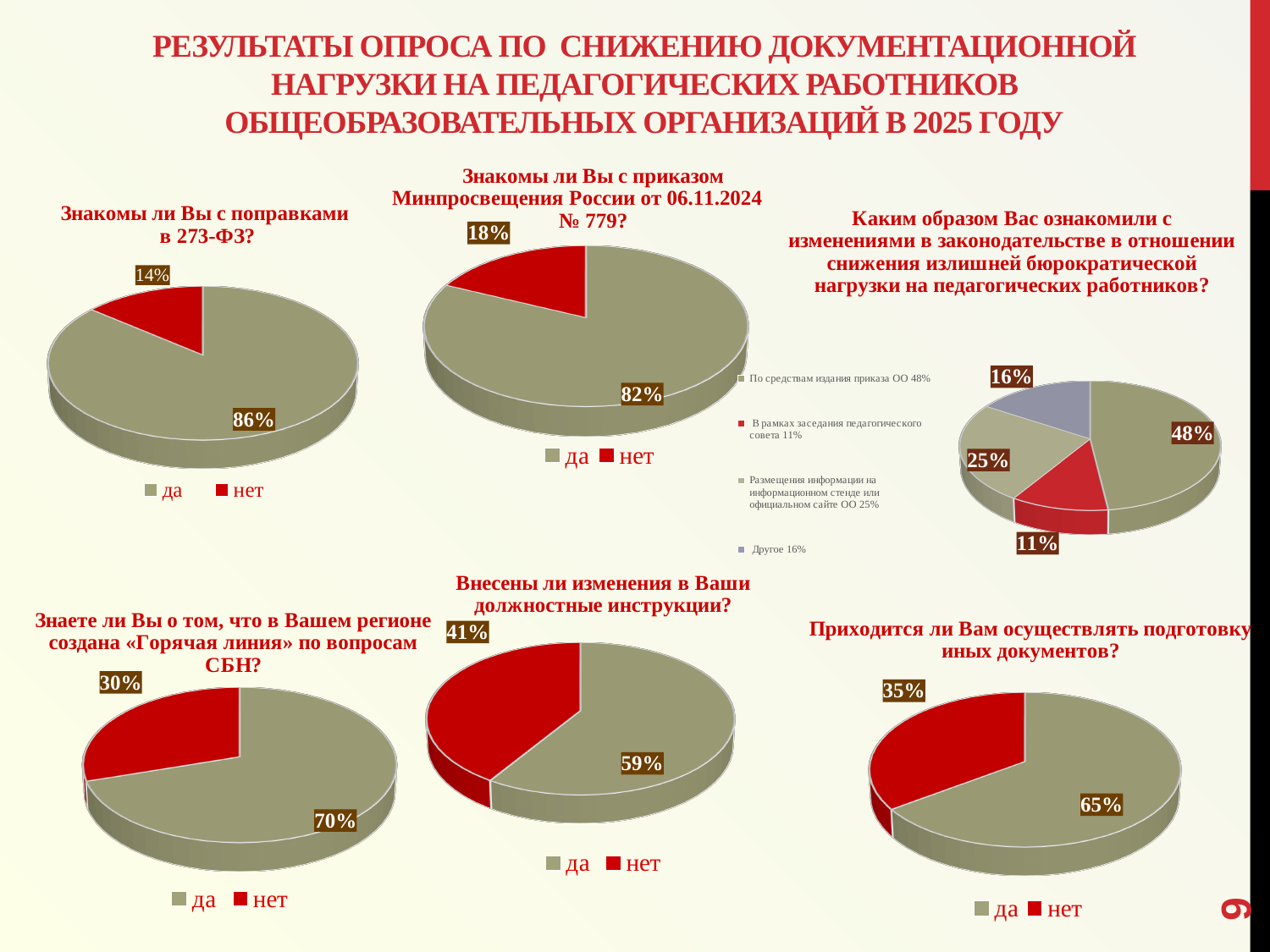
In the chart titled «Знакомы ли Вы с поправками в 273-ФЗ?», what share of respondents answered «нет»? 14% What type of chart is used for «Приходится ли Вам осуществлять подготовку иных документов?»? Pie chart In the chart titled «Каким образом Вас ознакомили с изменениями в законодательстве...», which category has the largest share? По средствам издания приказа ОО In the chart titled «Внесены ли изменения в Ваши должностные инструкции?», which answer has the larger share, «да» or «нет»? да In the chart titled «Каким образом Вас ознакомили с изменениями в законодательстве...», how many categories does the legend list? 4 In the chart titled «Каким образом Вас ознакомили с изменениями в законодательстве...», which category has the smallest share? В рамках заседания педагогического совета In the chart titled «Каким образом Вас ознакомили с изменениями в законодательстве...», what is the share for «Другое»? 16% In the chart titled «Знаете ли Вы о том, что в Вашем регионе создана «Горячая линия» по вопросам СБН?», what share answered «нет»? 30% In the chart titled «Знакомы ли Вы с приказом Минпросвещения России от 06.11.2024 № 779?», what is the value for «нет»? 18% In the chart titled «Приходится ли Вам осуществлять подготовку иных документов?», what share answered «да»? 65% In the chart titled «Знакомы ли Вы с поправками в 273-ФЗ?», what share of respondents answered «да»? 86% In the chart titled «Знакомы ли Вы с приказом Минпросвещения России от 06.11.2024 № 779?», what is the difference between the «да» and «нет» shares? 64%